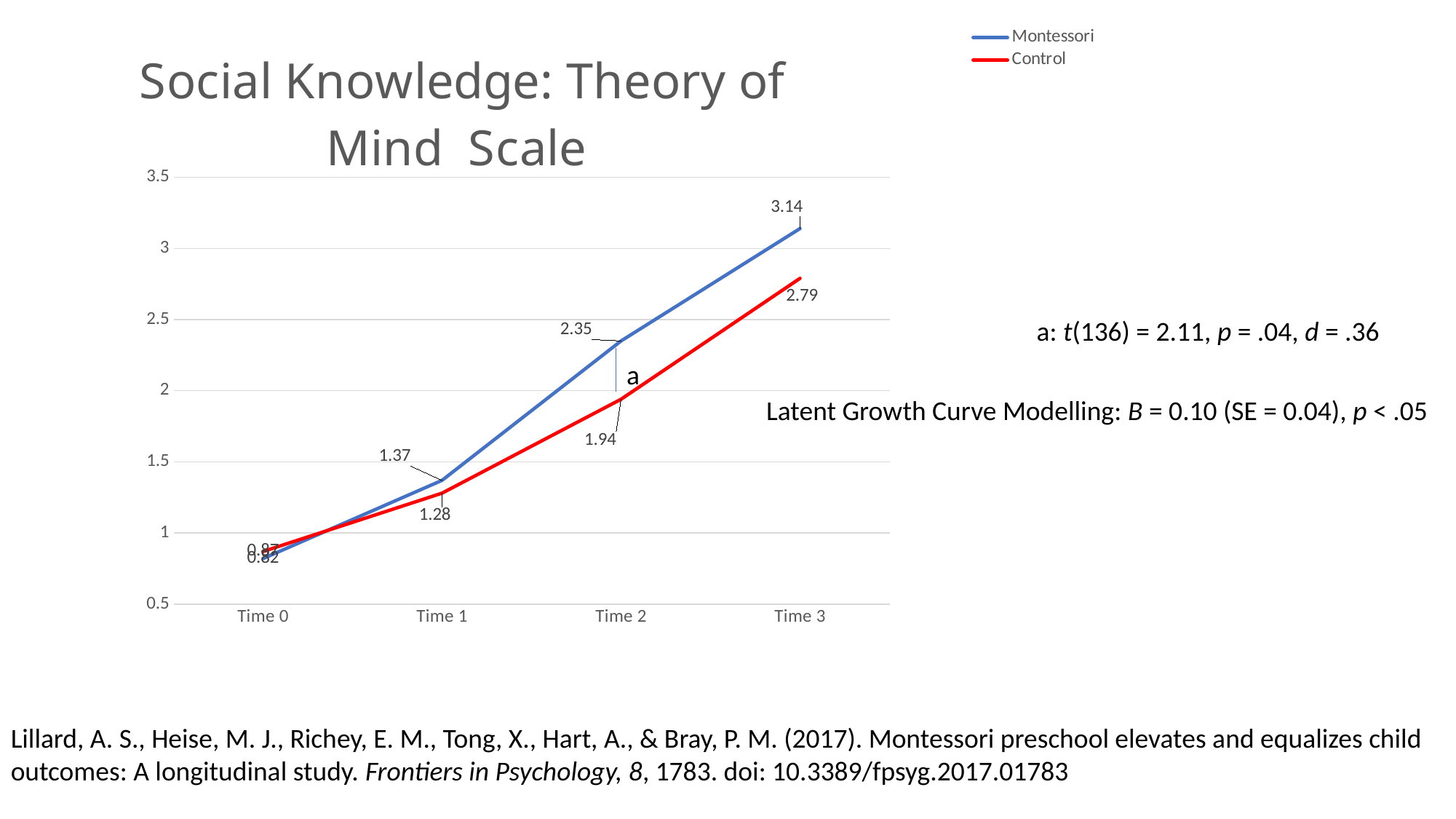
What is the value for Control at Time 2? 1.94 What kind of chart is shown on the slide? line chart At which time point does the Montessori series reach its highest value? Time 3 How many series does the legend list? 2 What is the value for Montessori at Time 2? 2.35 At Time 1, which series has the larger value, Montessori or Control? Montessori What is the difference between the Montessori and Control values at Time 2? 0.41 What is the value for Control at Time 3? 2.79 What is the value for Montessori at Time 1? 1.37 Do the Control values rise or fall from Time 0 to Time 3? rise What is the difference between the Montessori and Control values at Time 3? 0.35 How many time points are plotted on the x axis? 4